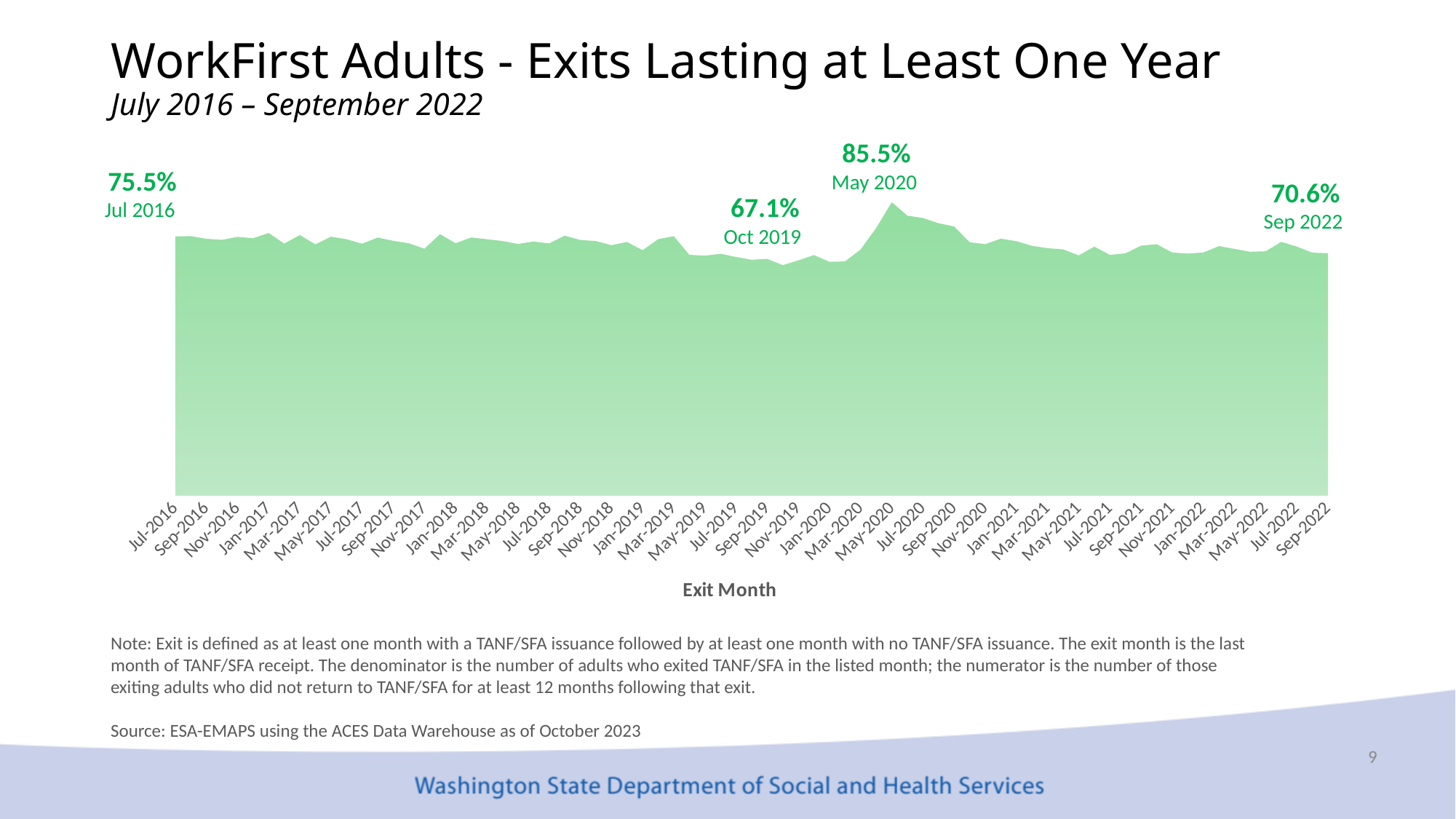
Which is larger, the value for Jul 2016 or the value for Sep 2022? Jul 2016 What value is labeled for Oct 2019? 67.1% What kind of chart is shown on the slide? Area chart Which labeled month has the highest value? May 2020 What value is labeled for Sep 2022? 70.6% Which labeled month has the lowest value? Oct 2019 What value is labeled for Jul 2016? 75.5% What is the difference between the Jul 2016 value and the Sep 2022 value? 4.9 percentage points What value is labeled for May 2020? 85.5% What is the difference between the May 2020 value and the Oct 2019 value? 18.4 percentage points How many data points have value labels printed on the chart? 4 What is the title of the x axis? Exit Month